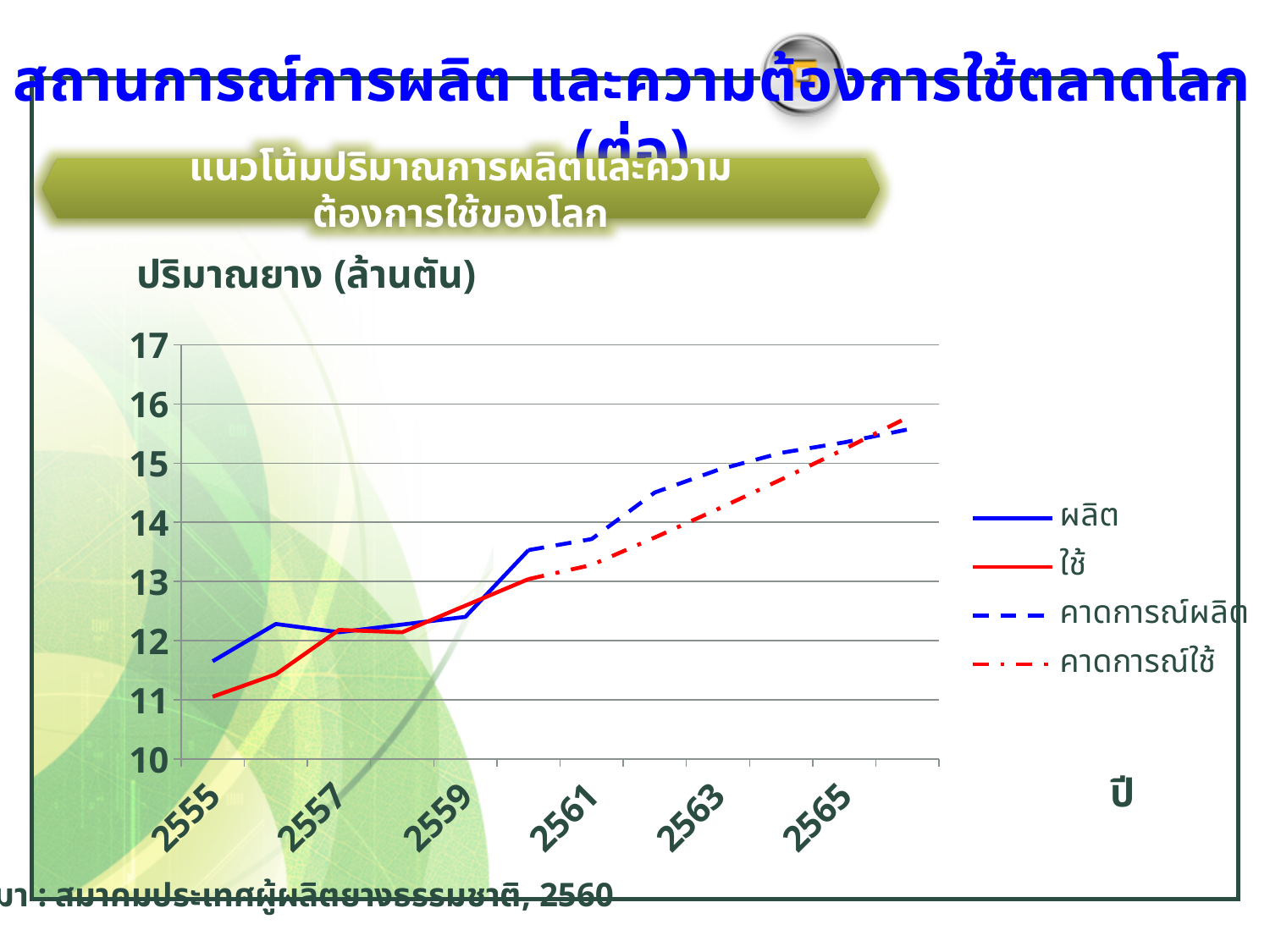
How many series does the legend list? 4 What is the y-axis title of the chart? ปริมาณยาง (ล้านตัน) Is the value for ผลิต in 2555 greater or less than 12? less Is the value for คาดการณ์ใช้ in 2561 greater or less than 14? less Is the value for ใช้ in 2555 greater or less than 12? less What kind of chart is shown on the slide? line chart How many year labels are shown on the x axis? 6 In 2555, which is larger, ผลิต or ใช้? ผลิต What are the four series listed in the legend? ผลิต, ใช้, คาดการณ์ผลิต, คาดการณ์ใช้ Does the ใช้ series rise or fall from 2555 to 2560? rise In 2563, which is larger, คาดการณ์ผลิต or คาดการณ์ใช้? คาดการณ์ผลิต